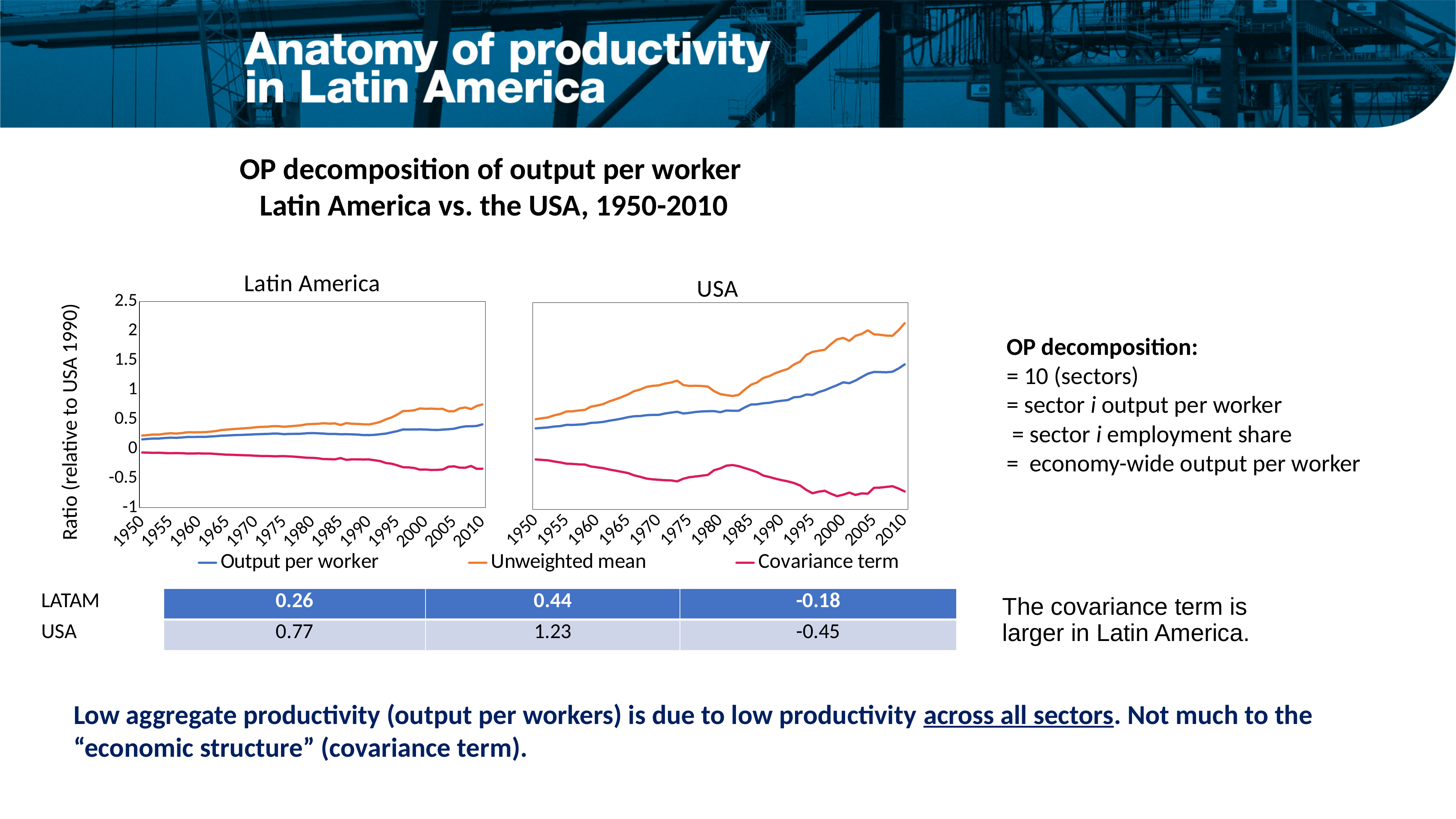
What is the label of the vertical axis shared by the two charts? Ratio (relative to USA 1990) In the USA chart, which series has the lowest value in 2010? Covariance term Which chart shows the larger Unweighted mean value in 2010, Latin America or USA? USA How many series does the shared legend below the charts list? 3 In the USA chart, does the Unweighted mean series rise or fall overall from 1950 to 2010? rise In the USA chart, is the value of Covariance term in 2010 greater or less than -0.5? less In the USA chart, which series has the highest value in 2010? Unweighted mean In the Latin America chart, is the value of Unweighted mean in 2010 greater or less than 0.5? greater In the USA chart, does the Covariance term series rise or fall overall from 1950 to 2010? fall How many charts are plotted on the slide? 2 In the USA chart, is the value of Output per worker in 2010 greater or less than 1? greater What kind of chart is the Latin America chart? line chart